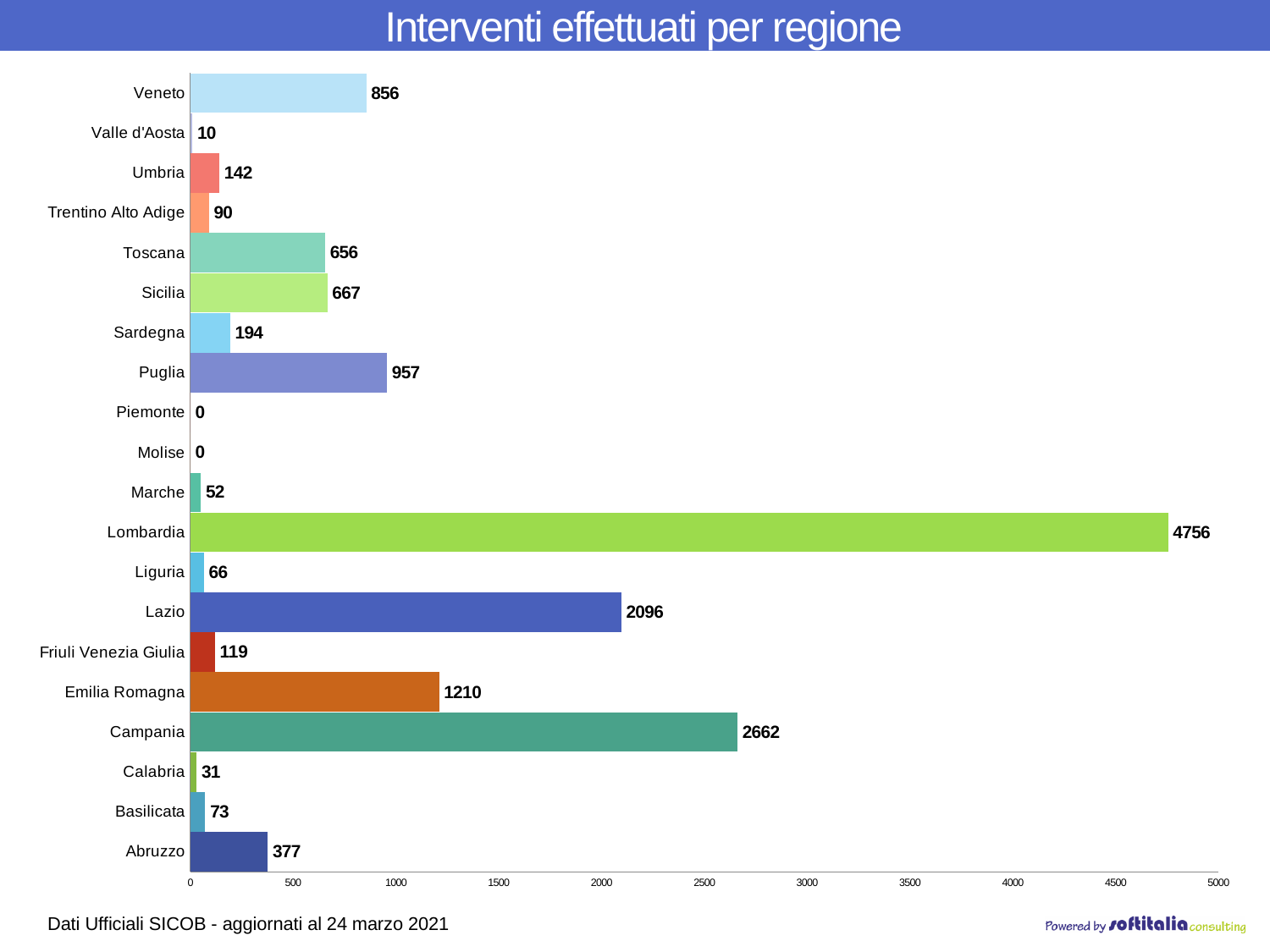
Which regions have a value of 0? Piemonte and Molise Which region has the highest value? Lombardia What is the value for Campania? 2662 What is the value for Valle d'Aosta? 10 How many regions are shown on the chart? 20 Is the value for Campania greater or less than 2500? greater Which is larger, the value for Veneto or the value for Puglia? Puglia What is the difference between the values for Toscana and Sicilia? 11 What is the value for Lombardia? 4756 What is the title of the chart? Interventi effettuati per regione What kind of chart is shown on the slide? Bar chart What is the difference between the values for Lazio and Emilia Romagna? 886